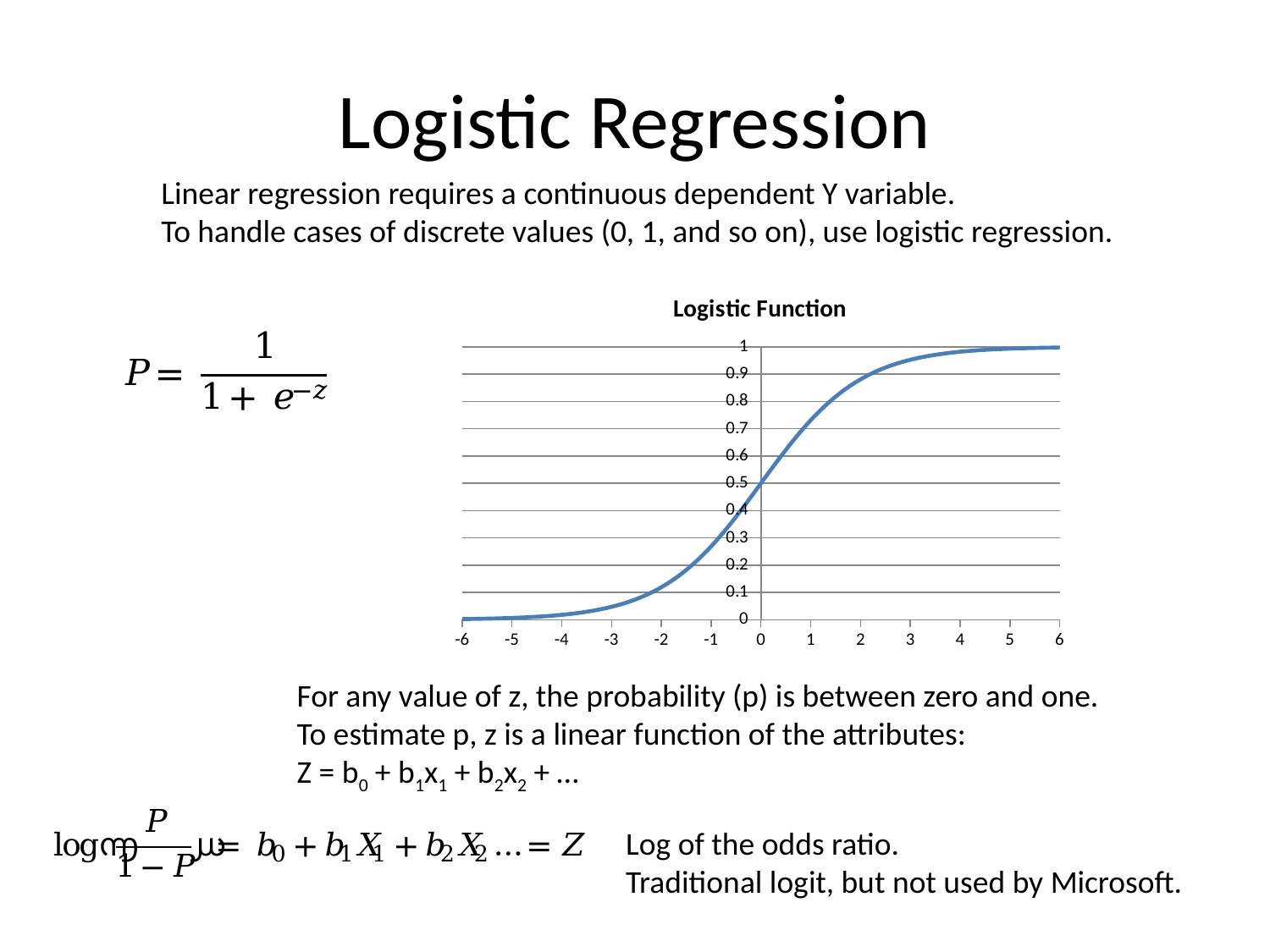
Is the value of the logistic function at x = 1 greater or less than 0.7? greater Is the value of the logistic function at x = 3 greater or less than 0.9? greater What is the value of the logistic function at x = 0? 0.5 Is the value of the logistic function at x = 2 greater or less than 0.8? greater What is the title of the chart? Logistic Function Do the values of the plotted line rise or fall as the x axis goes from -6 to 6? rise Which is larger, the value of the logistic function at x = -1 or at x = 1? x = 1 How many lines are plotted on the chart? 1 How many tick labels are shown on the x axis of the chart? 13 What kind of chart is shown on the slide? line chart